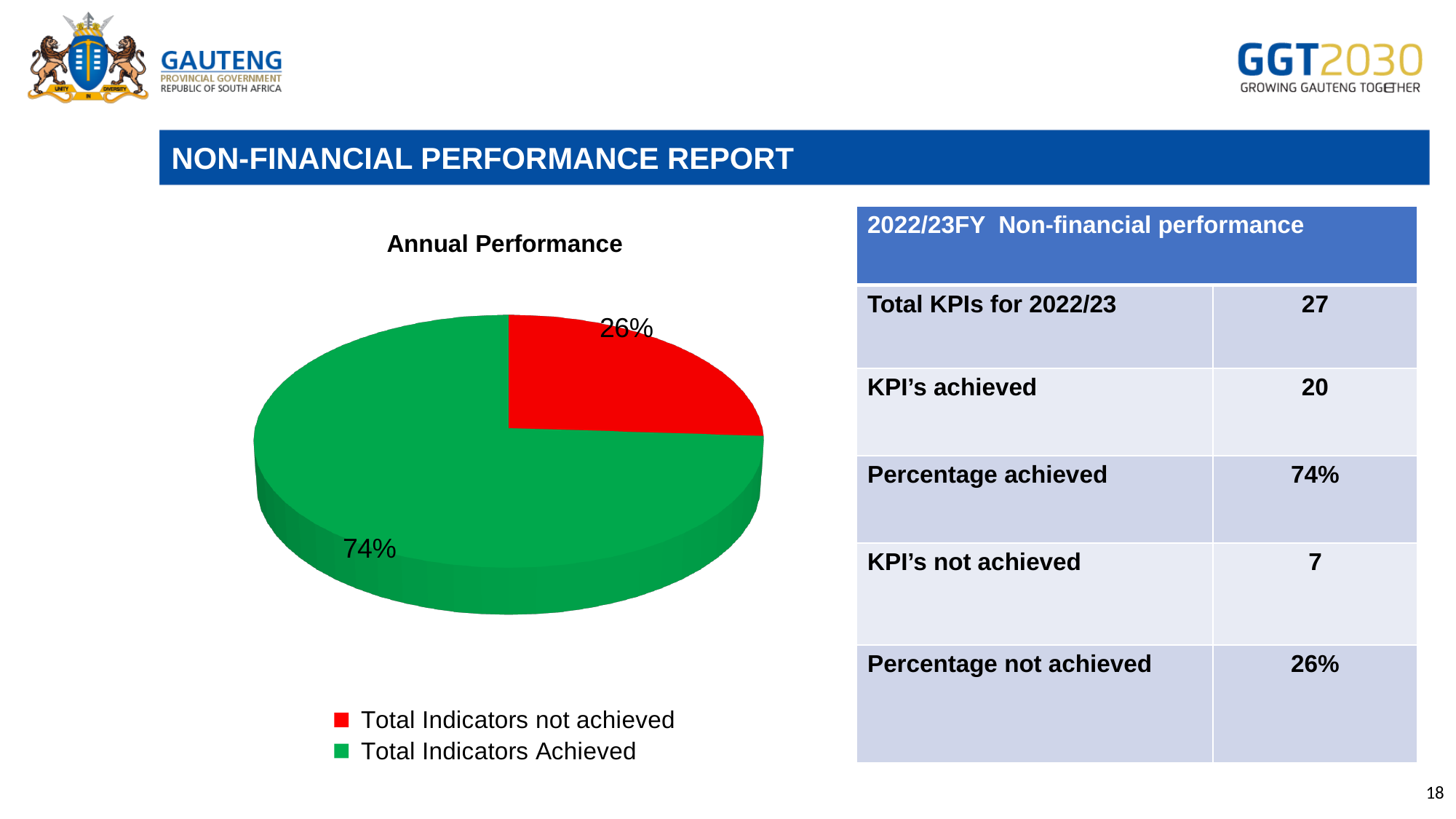
How many entries does the legend list? 2 Which slice of the pie is the smallest? Total Indicators not achieved What colour is the Total Indicators not achieved slice? Red What type of chart is shown on the slide? Pie chart Which slice of the pie is the largest? Total Indicators Achieved What is the difference in percentage points between the Total Indicators Achieved slice and the Total Indicators not achieved slice? 48 How many slices does the pie chart have? 2 What share of the pie is labelled for Total Indicators Achieved? 74% What is the title of the chart? Annual Performance What share of the pie is labelled for Total Indicators not achieved? 26% Which is larger: the Total Indicators Achieved slice or the Total Indicators not achieved slice? Total Indicators Achieved